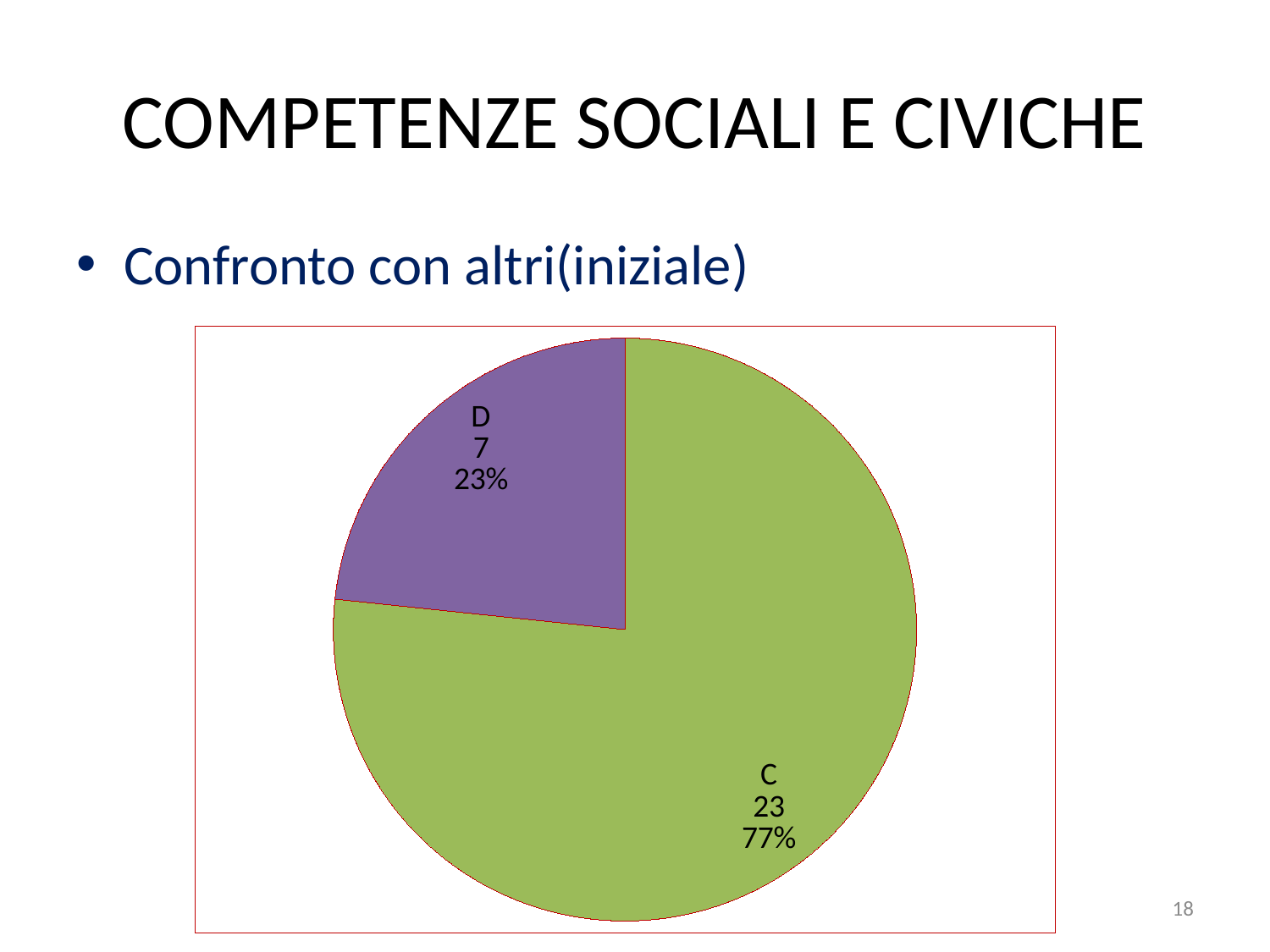
How many slices does the pie chart have? 2 What share of the pie does slice D represent? 23% What is the value for slice C? 23 What kind of chart is shown on the slide? pie chart What share of the pie does slice C represent? 77% Which slice is the largest? C Which slice is the smallest? D What is the total of the values shown in the pie chart? 30 Which is larger, the value for C or the value for D? C What colour is the slice for D? purple What is the value for slice D? 7 What is the difference between the values of C and D? 16